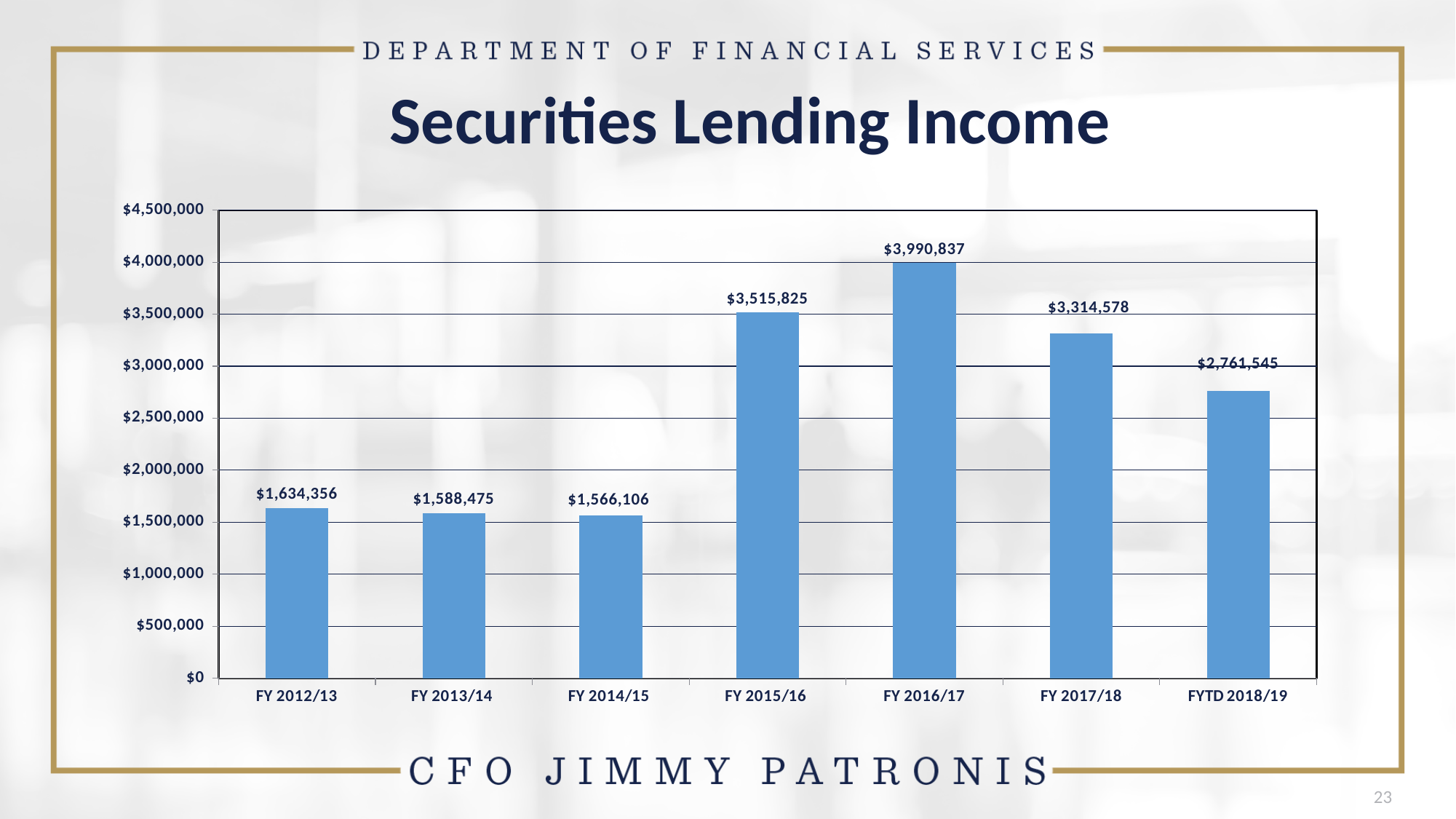
What kind of chart is shown on the slide? bar chart What is the securities lending income for FY 2013/14? $1,588,475 What is the difference between the securities lending income for FY 2017/18 and FYTD 2018/19? $553,033 What is the difference between the securities lending income for FY 2016/17 and FY 2015/16? $475,012 What is the securities lending income for FYTD 2018/19? $2,761,545 How many fiscal years are shown on the chart? 7 Which fiscal year has the highest securities lending income? FY 2016/17 Is the securities lending income for FYTD 2018/19 greater or less than $3,000,000? less Which is larger, the securities lending income for FY 2015/16 or FY 2017/18? FY 2015/16 Do the values rise or fall from FY 2016/17 to FYTD 2018/19? fall What is the securities lending income for FY 2016/17? $3,990,837 Which fiscal year has the lowest securities lending income? FY 2014/15